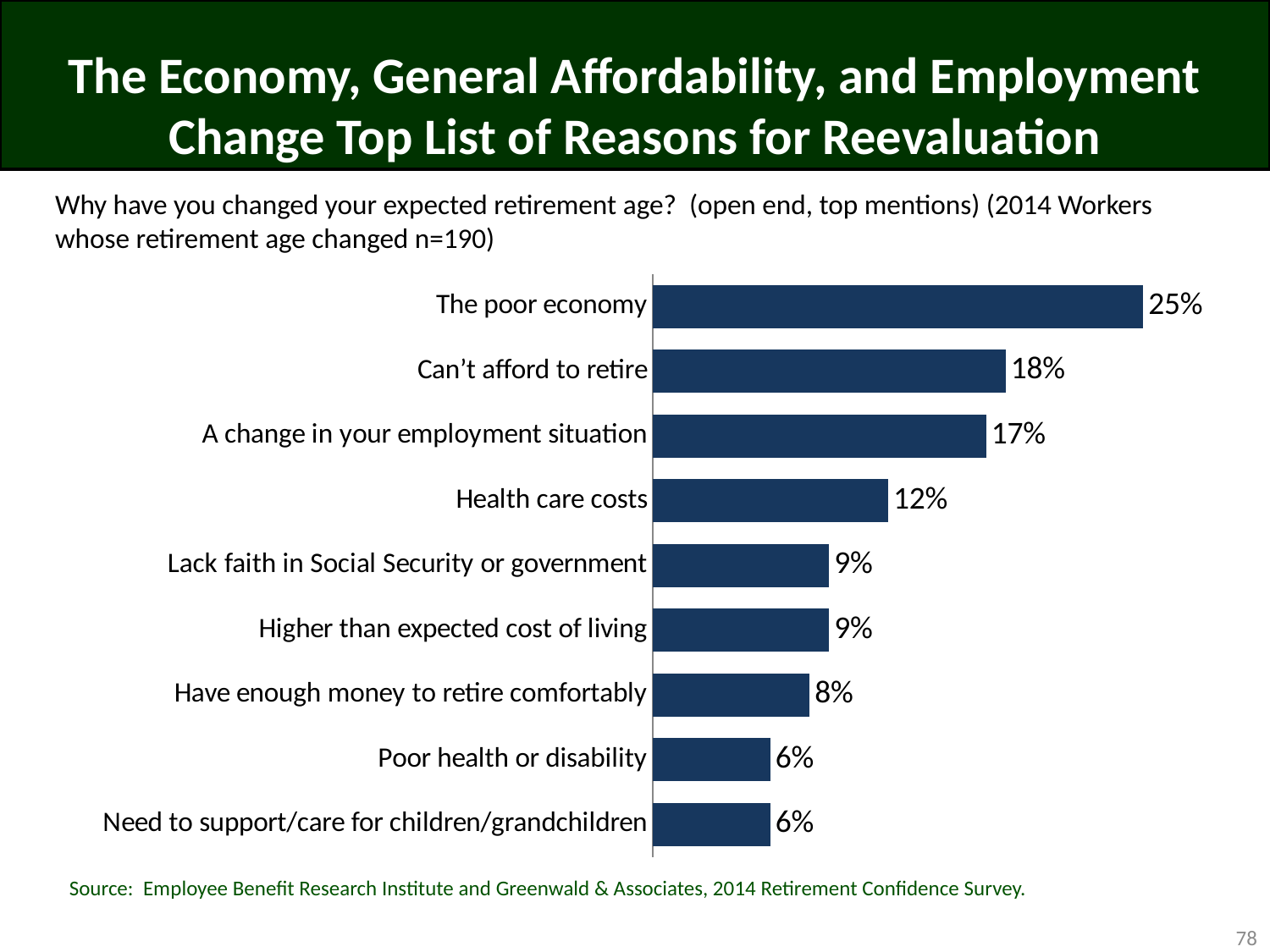
Which two reasons both have a value of 9%? Lack faith in Social Security or government; Higher than expected cost of living What is the difference in percentage points between "Can't afford to retire" and "A change in your employment situation"? 1 Which reason has the highest percentage? The poor economy Which is larger: the value for "Health care costs" or the value for "Lack faith in Social Security or government"? Health care costs What percentage of workers cited the poor economy as a reason for changing their expected retirement age? 25% How many reasons (categories) are shown in the chart? 9 What is the difference in percentage points between "The poor economy" and "Health care costs"? 13 What kind of chart is shown on the slide? Bar chart What is the value for "Have enough money to retire comfortably"? 8% What is the sample size (n) stated for the survey question on the slide? n=190 What value is shown for "Poor health or disability"? 6% What is the value for "Health care costs"? 12%